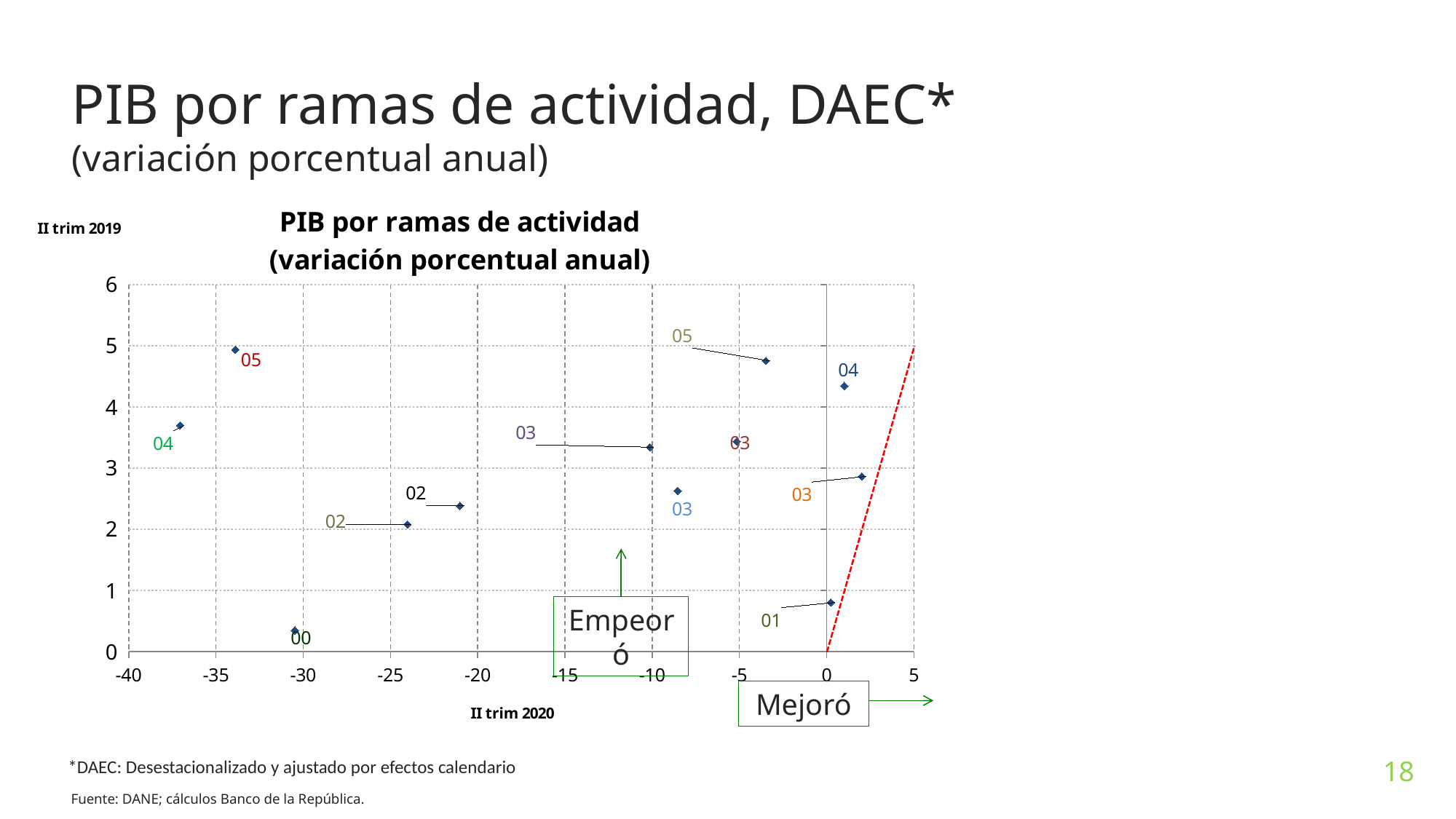
Is the highest plotted point's vertical-axis value greater or less than 4? greater What label is shown on the horizontal axis of the chart? II trim 2020 How many data points are plotted in the chart? 12 Is the lowest plotted point's vertical-axis value greater or less than 1? less What kind of chart is shown on the slide? scatter chart What is the title of the chart? PIB por ramas de actividad (variación porcentual anual)